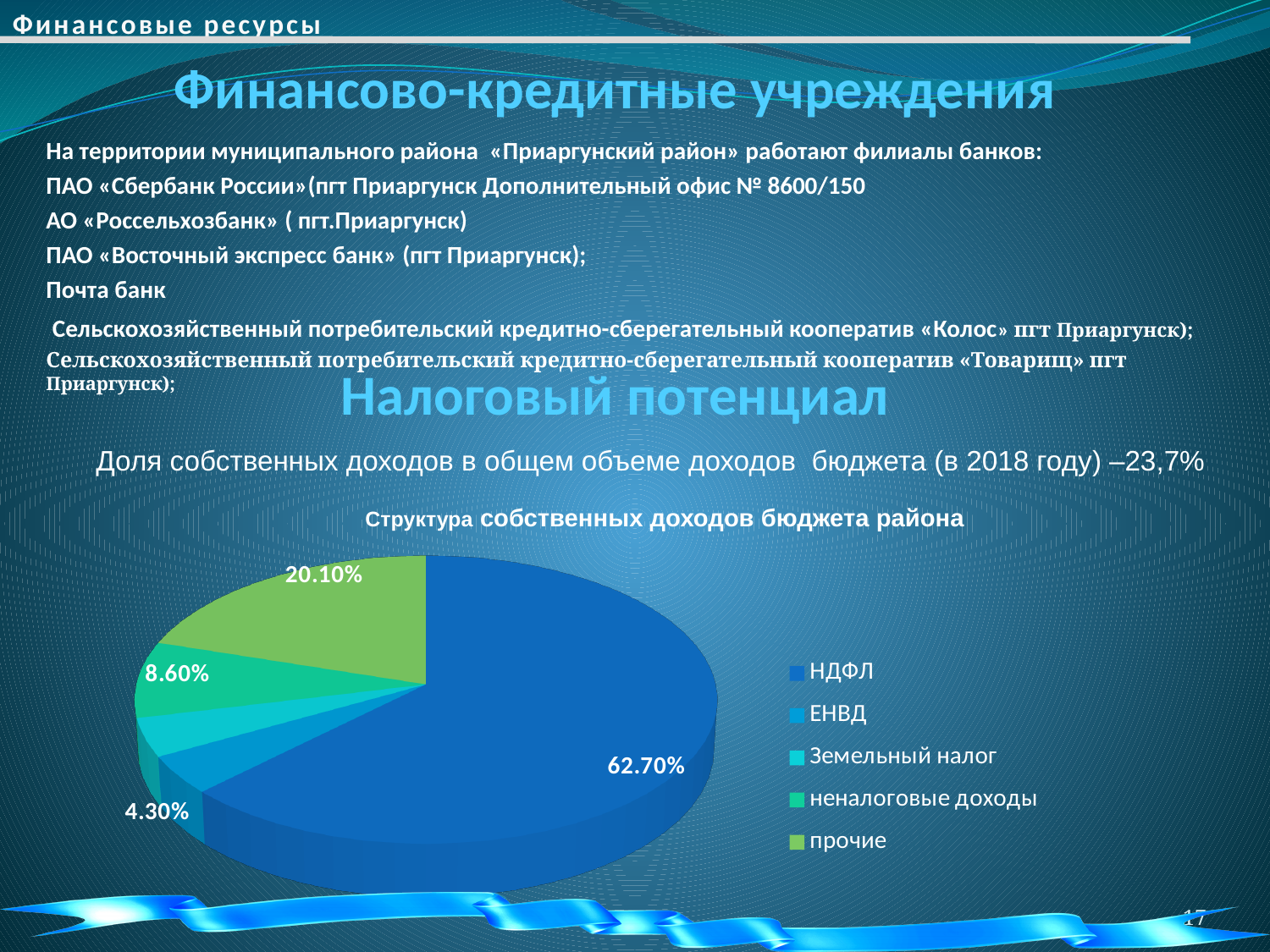
What is the value shown for прочие in the pie chart? 20.10% How many categories does the pie chart legend list? 5 What type of chart is shown on the slide? pie chart What is the smallest percentage label printed on the pie chart? 4.30% Which legend entry is shown in dark blue in the pie chart? НДФЛ Which is larger, the share for ЕНВД or the share for прочие? прочие What share of the pie does НДФЛ have? 62.70% What is the difference between the НДФЛ share and the прочие share? 42.60% Which category has the largest slice of the pie? НДФЛ Is the share for НДФЛ greater or less than 50%? greater What is the value shown for ЕНВД in the pie chart? 4.30% What is the title of the pie chart? Структура собственных доходов бюджета района